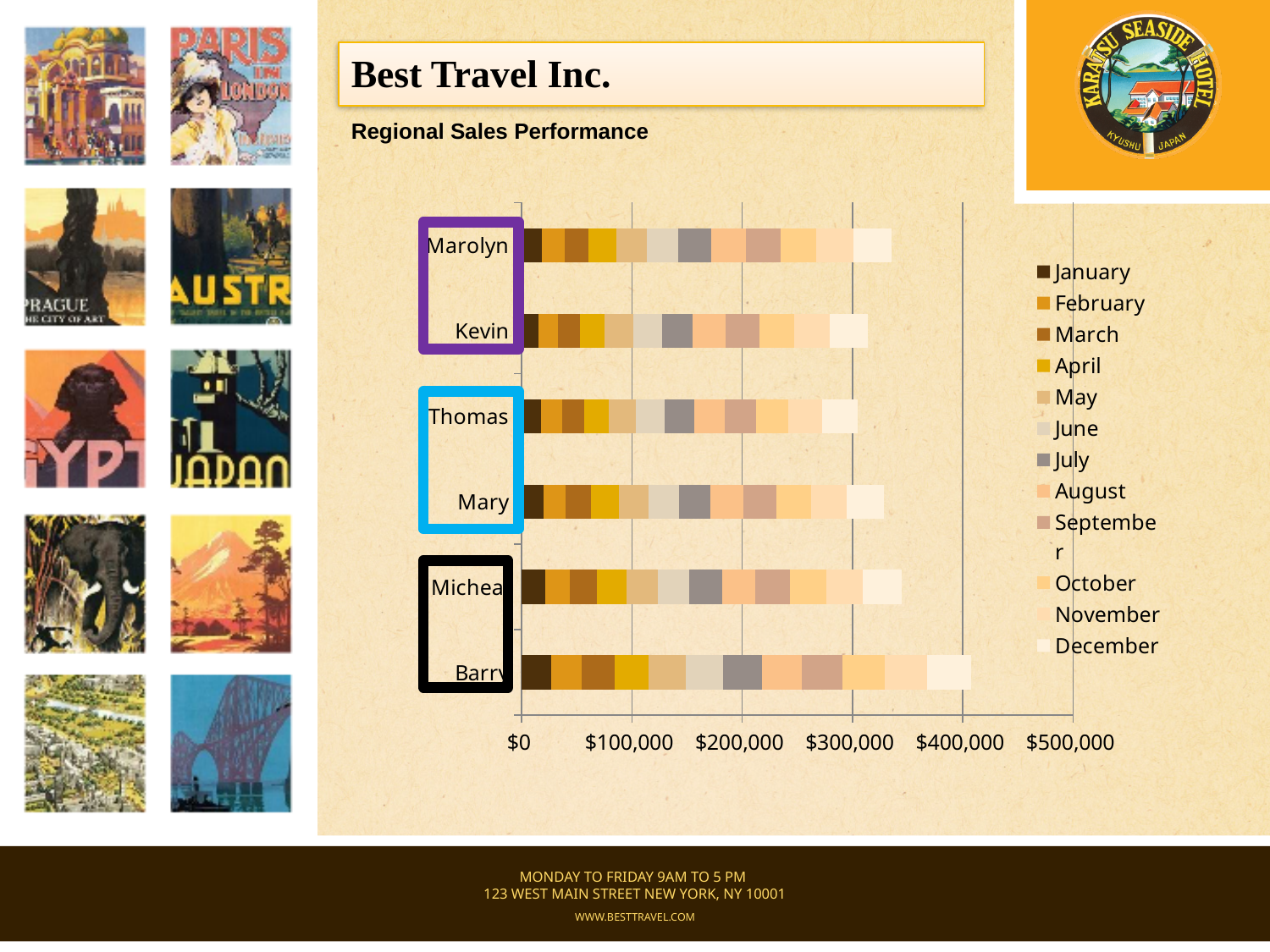
Which has a larger total, Barry or Thomas? Barry What kind of chart is shown on the slide? Stacked bar chart How many salespeople (categories) are shown on the chart? 6 What is the first series listed in the chart legend? January How many series does the chart legend list? 12 Which salesperson has the highest total sales on the chart? Barry Is the total value for Barry greater or less than $300,000? greater Is the total value for Micheal greater or less than $400,000? less Which has a larger total, Barry or Marolyn? Barry Is the total value for Thomas greater or less than $400,000? less What is the title of the chart on the slide? Regional Sales Performance